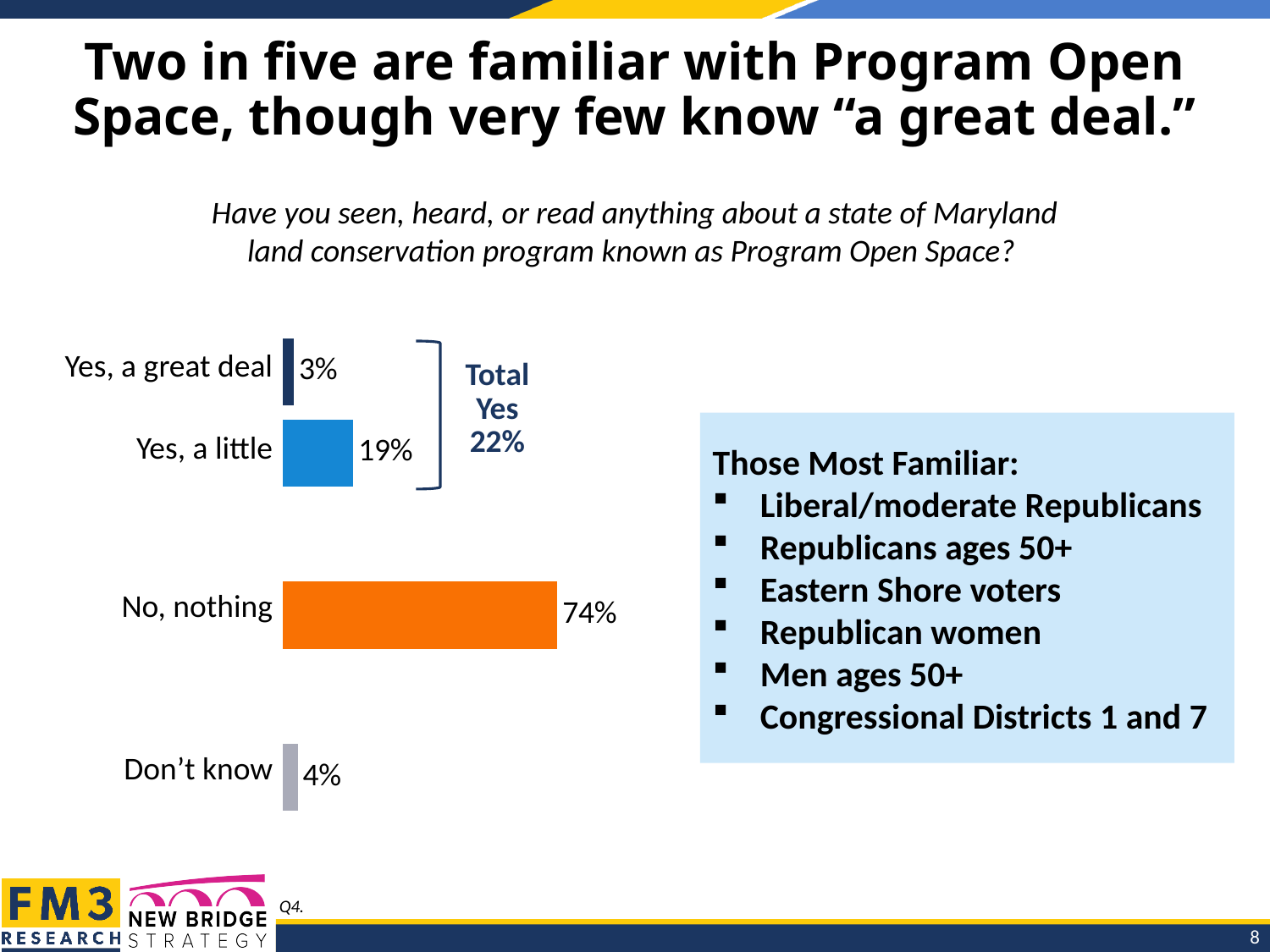
Which response category has the highest percentage? No, nothing What percentage of respondents said "No, nothing"? 74% What percentage of respondents said "Yes, a little"? 19% What percentage of respondents said "Don't know"? 4% What is the difference in percentage points between "No, nothing" and "Yes, a little"? 55 Which is larger, the percentage for "Don't know" or for "Yes, a great deal"? Don't know Which response category has the lowest percentage? Yes, a great deal What kind of chart is shown on the slide? Bar chart What is the "Total Yes" percentage shown on the chart? 22% What percentage of respondents said "Yes, a great deal"? 3% What colour is the bar for "No, nothing"? Orange How many response categories are shown in the chart? 4